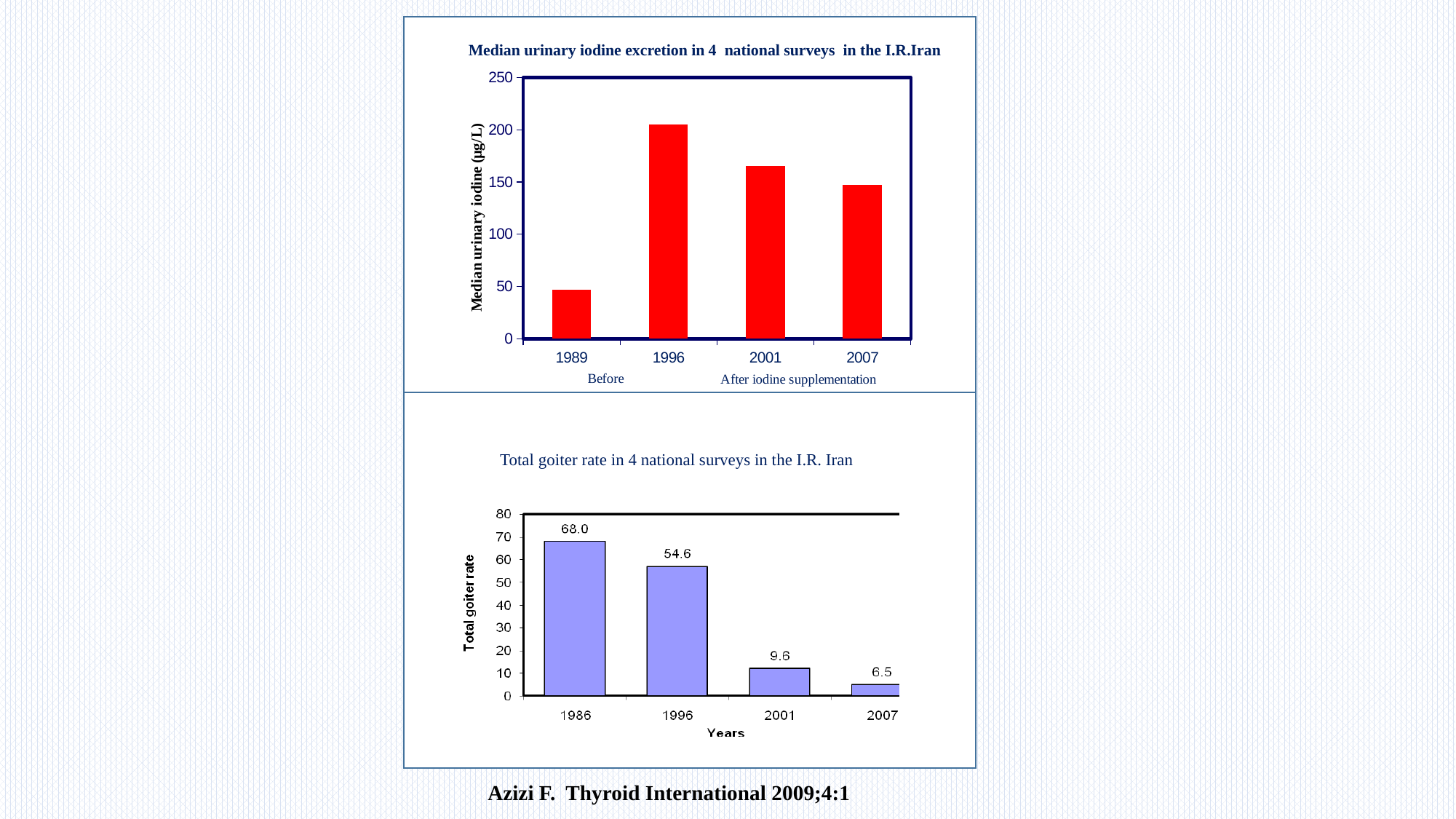
In the top chart, 'Median urinary iodine excretion in 4 national surveys in the I.R.Iran', which year has the highest bar? 1996 In the bottom chart, 'Total goiter rate in 4 national surveys in the I.R. Iran', how many years are shown on the x axis? 4 In the top chart, 'Median urinary iodine excretion in 4 national surveys in the I.R.Iran', is the value for 1996 greater or less than 200? greater In the top chart, 'Median urinary iodine excretion in 4 national surveys in the I.R.Iran', is the value for 2001 greater or less than 150? greater In the top chart, 'Median urinary iodine excretion in 4 national surveys in the I.R.Iran', which is larger, the value for 2001 or the value for 2007? 2001 In the top chart, 'Median urinary iodine excretion in 4 national surveys in the I.R.Iran', which year has the lowest bar? 1989 In the bottom chart, 'Total goiter rate in 4 national surveys in the I.R. Iran', what is the difference between the values for 1986 and 1996? 13.4 In the bottom chart, 'Total goiter rate in 4 national surveys in the I.R. Iran', what is the total goiter rate for 1986? 68.0 In the bottom chart, 'Total goiter rate in 4 national surveys in the I.R. Iran', do the values rise or fall from 1986 to 2007? fall In the bottom chart, 'Total goiter rate in 4 national surveys in the I.R. Iran', what is the total goiter rate for 2007? 6.5 In the top chart, 'Median urinary iodine excretion in 4 national surveys in the I.R.Iran', what kind of chart is shown? bar chart